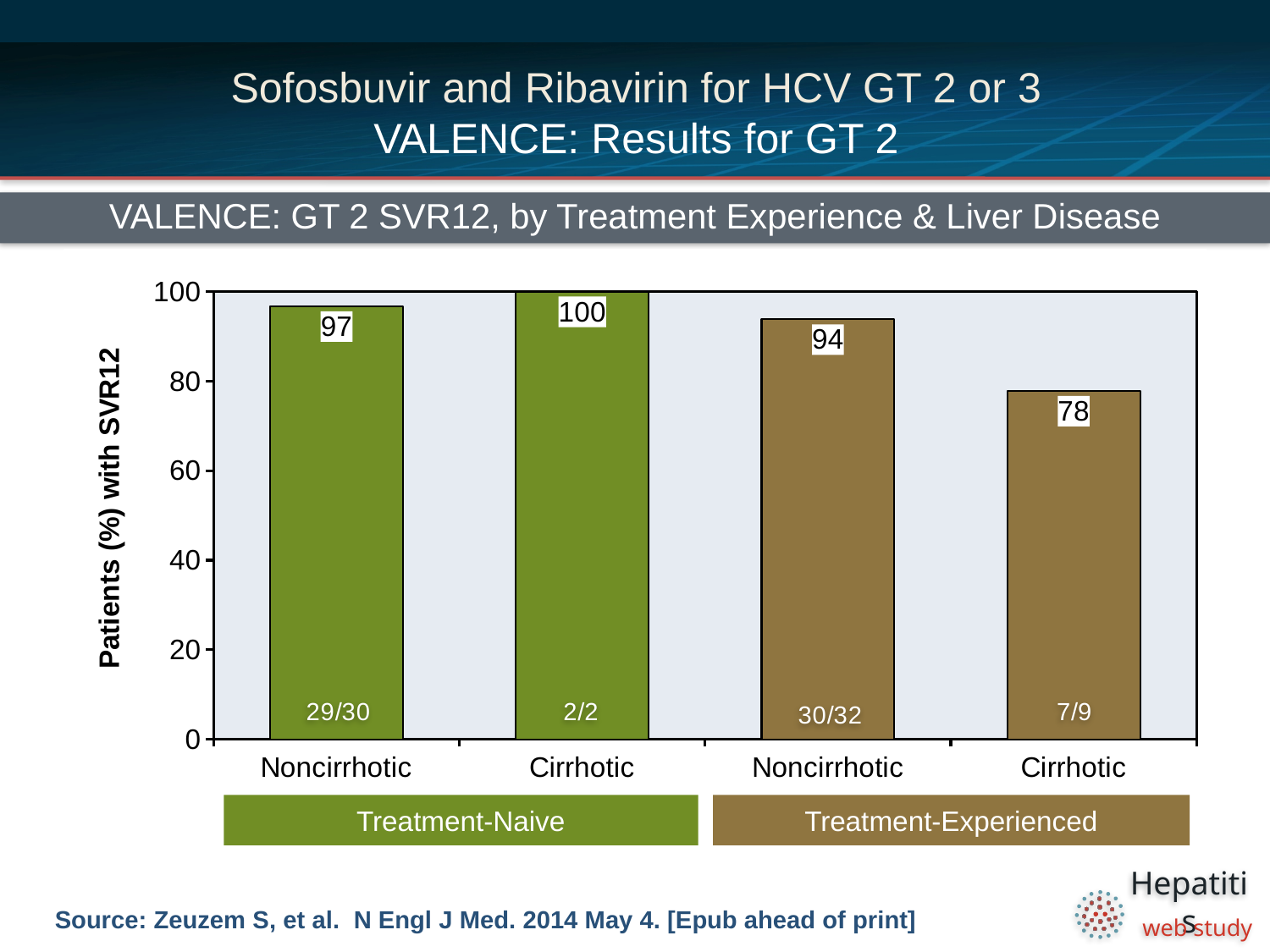
What fraction of patients is shown inside the Treatment-Naive Cirrhotic bar? 2/2 What is the difference in SVR12 rate between Treatment-Naive Noncirrhotic and Treatment-Experienced Cirrhotic patients? 19 What is the SVR12 rate for Treatment-Experienced Cirrhotic patients? 78 Which has a higher SVR12 rate: Treatment-Experienced Noncirrhotic or Treatment-Experienced Cirrhotic? Treatment-Experienced Noncirrhotic Which group has the lowest SVR12 rate? Treatment-Experienced Cirrhotic What is the label of the y-axis? Patients (%) with SVR12 What is the SVR12 rate for Treatment-Experienced Noncirrhotic patients? 94 How many bars are shown in the chart? 4 What type of chart is shown on the slide? Bar chart Which group has the highest SVR12 rate? Treatment-Naive Cirrhotic Is the SVR12 rate for Treatment-Experienced Cirrhotic patients greater or less than 80? less What is the SVR12 rate for Treatment-Naive Noncirrhotic patients? 97